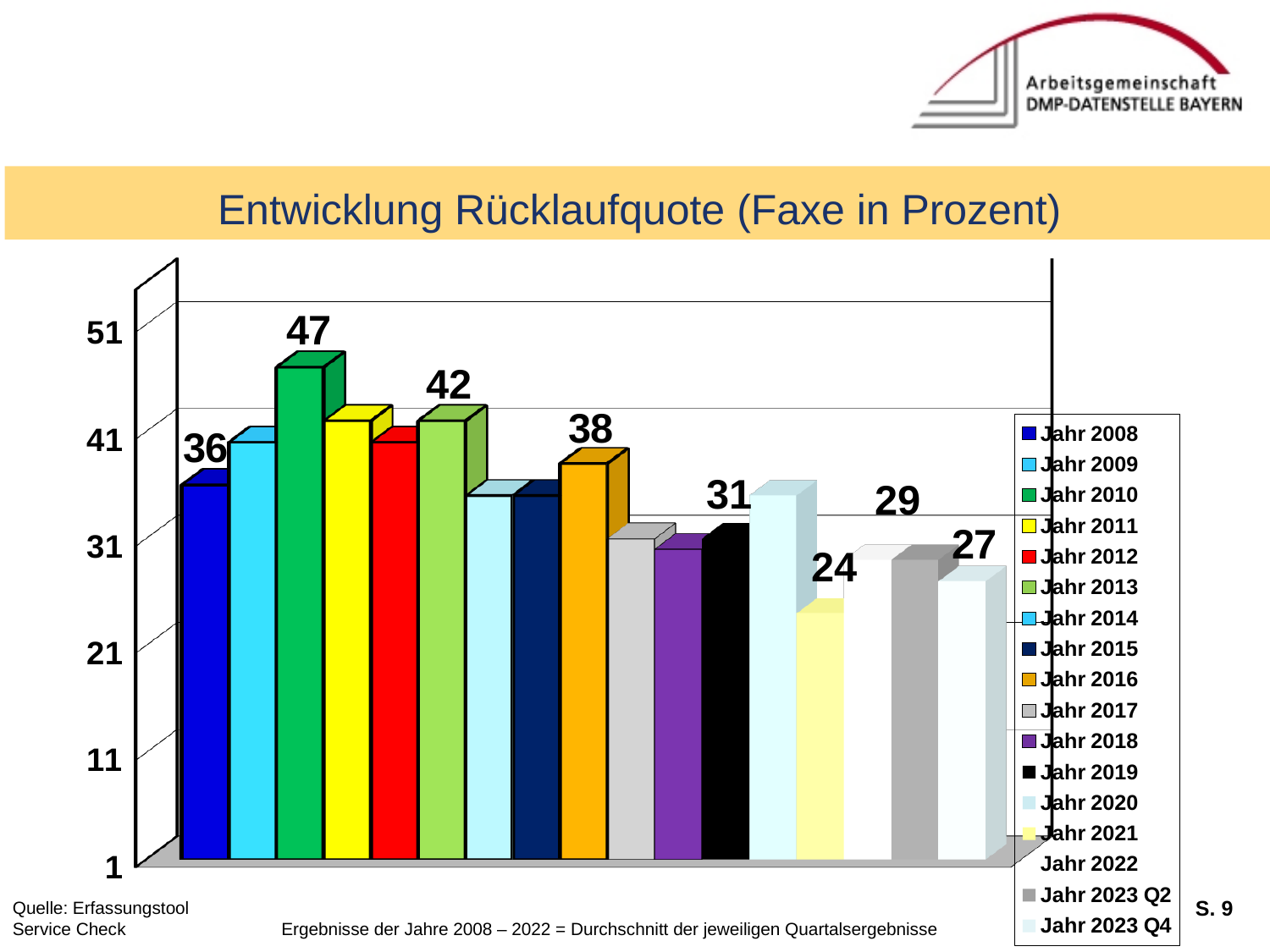
Which year has the highest return rate? Jahr 2010 What is the value for Jahr 2023 Q4? 27 Is the value for Jahr 2009 greater or less than 31? greater What is the difference between the values for Jahr 2010 and Jahr 2008? 11 What kind of chart is shown on the slide? bar chart What is the value for Jahr 2021? 24 What is the value for Jahr 2013? 42 Which year has the lowest return rate? Jahr 2021 Which is larger, the value for Jahr 2016 or for Jahr 2019? Jahr 2016 What is the value for Jahr 2016? 38 What is the value for Jahr 2010? 47 How many series does the legend list? 17